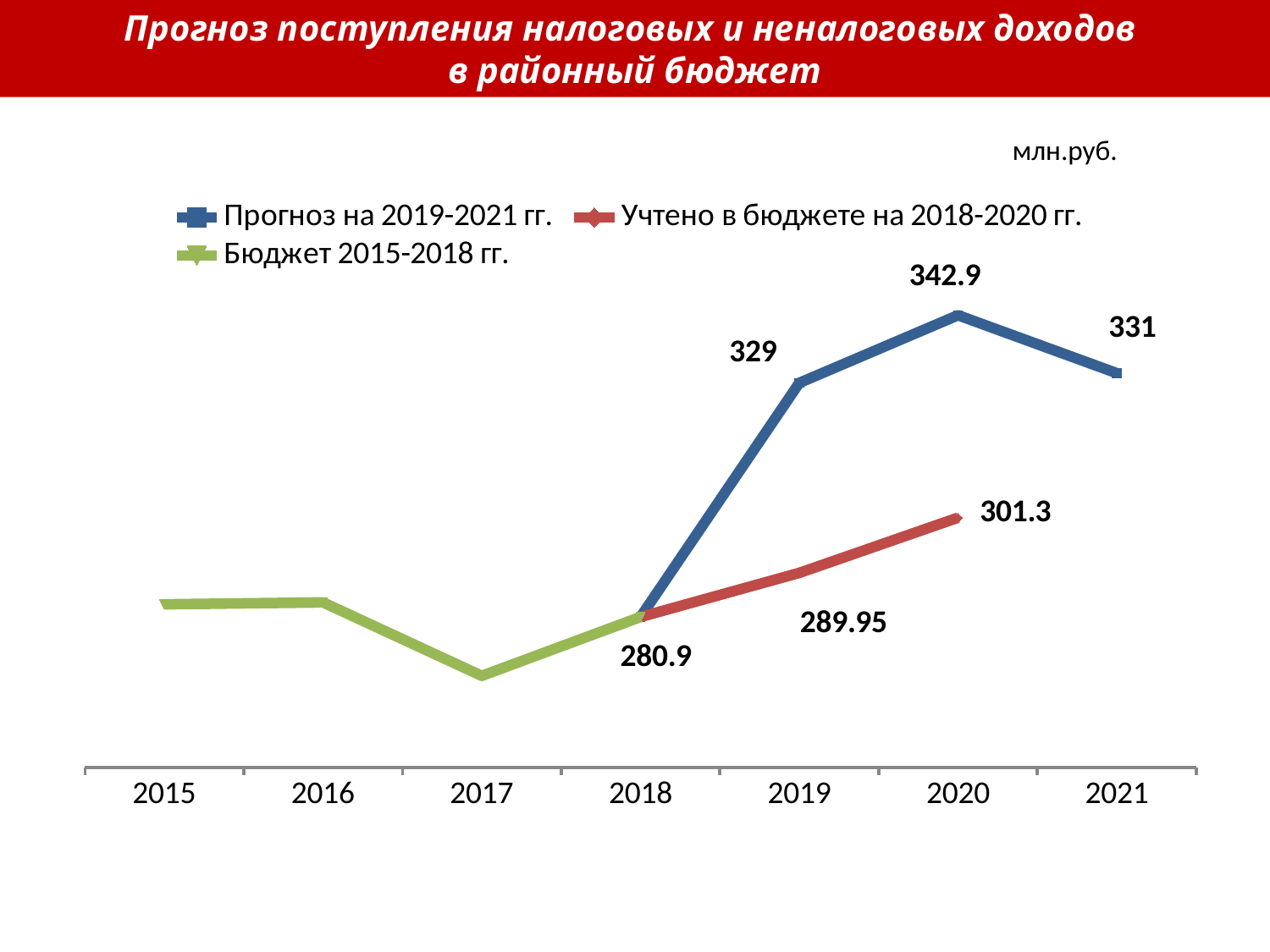
In which year does the 'Прогноз на 2019-2021 гг.' series reach its highest value? 2020 What kind of chart is shown on the slide? line chart What value is labelled for 2018? 280.9 What is the value of the 'Прогноз на 2019-2021 гг.' series for 2021? 331 What is the value of the 'Учтено в бюджете на 2018-2020 гг.' series for 2019? 289.95 What is the value of the 'Прогноз на 2019-2021 гг.' series for 2019? 329 How many series does the legend list? 3 What is the value of the 'Прогноз на 2019-2021 гг.' series for 2020? 342.9 Which is larger for 2019: the 'Прогноз на 2019-2021 гг.' value or the 'Учтено в бюджете на 2018-2020 гг.' value? Прогноз на 2019-2021 гг. What is the difference between the 'Прогноз на 2019-2021 гг.' value and the 'Учтено в бюджете на 2018-2020 гг.' value for 2020? 41.6 How many years are shown on the x axis? 7 What is the value of the 'Учтено в бюджете на 2018-2020 гг.' series for 2020? 301.3